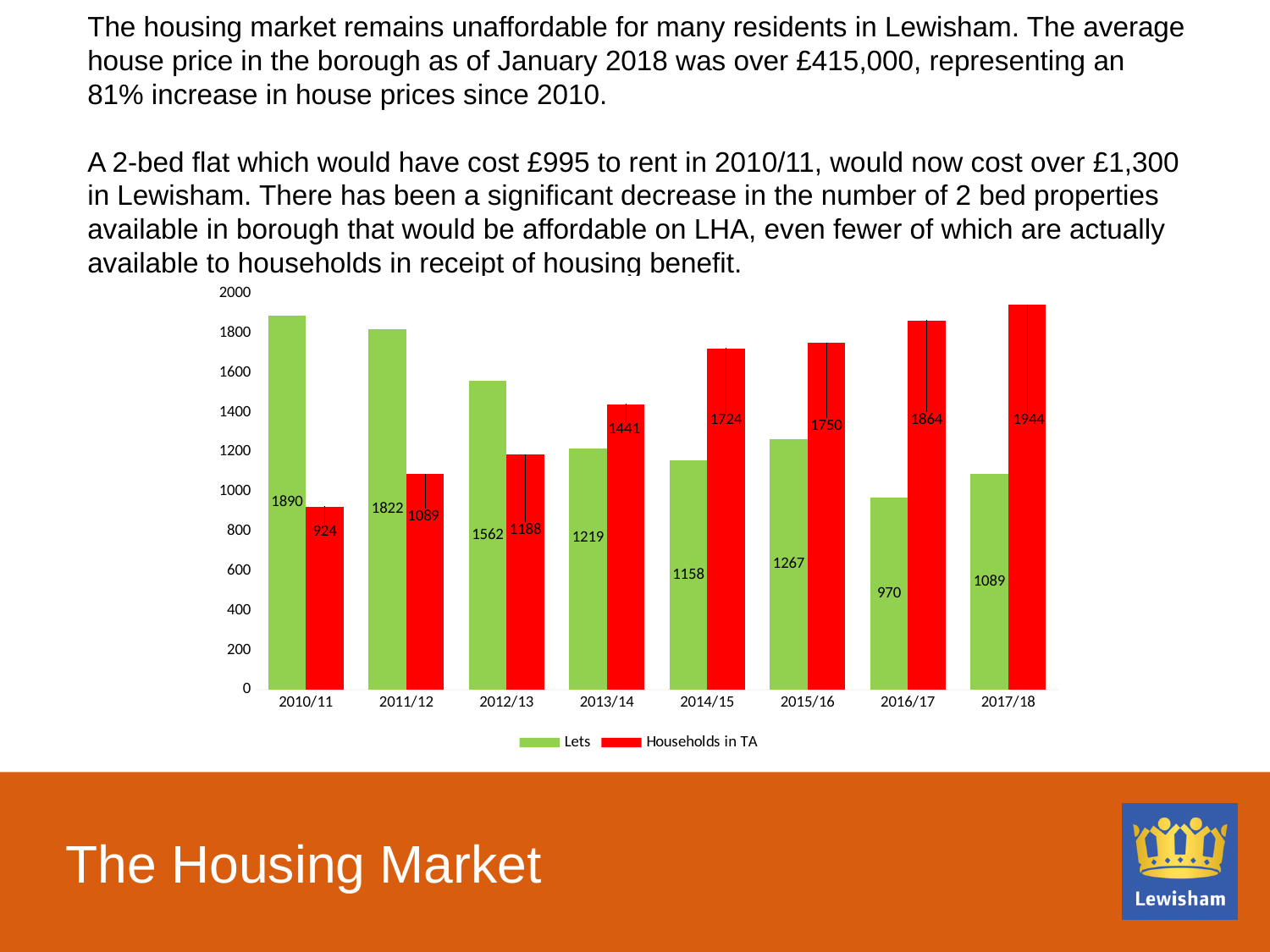
What kind of chart is shown on the slide? bar chart How many series does the legend list? 2 What is the value for Households in TA in 2017/18? 1944 What is the difference between Households in TA and Lets in 2017/18? 855 What is the value for Lets in 2016/17? 970 Which year has the highest value for Households in TA? 2017/18 Which is larger in 2012/13, Lets or Households in TA? Lets Do the values for Households in TA rise or fall from 2010/11 to 2017/18? rise What is the value for Lets in 2010/11? 1890 Is the value for Households in TA in 2014/15 greater or less than 1600? greater Which year has the lowest value for Lets? 2016/17 How many years are shown on the x axis? 8